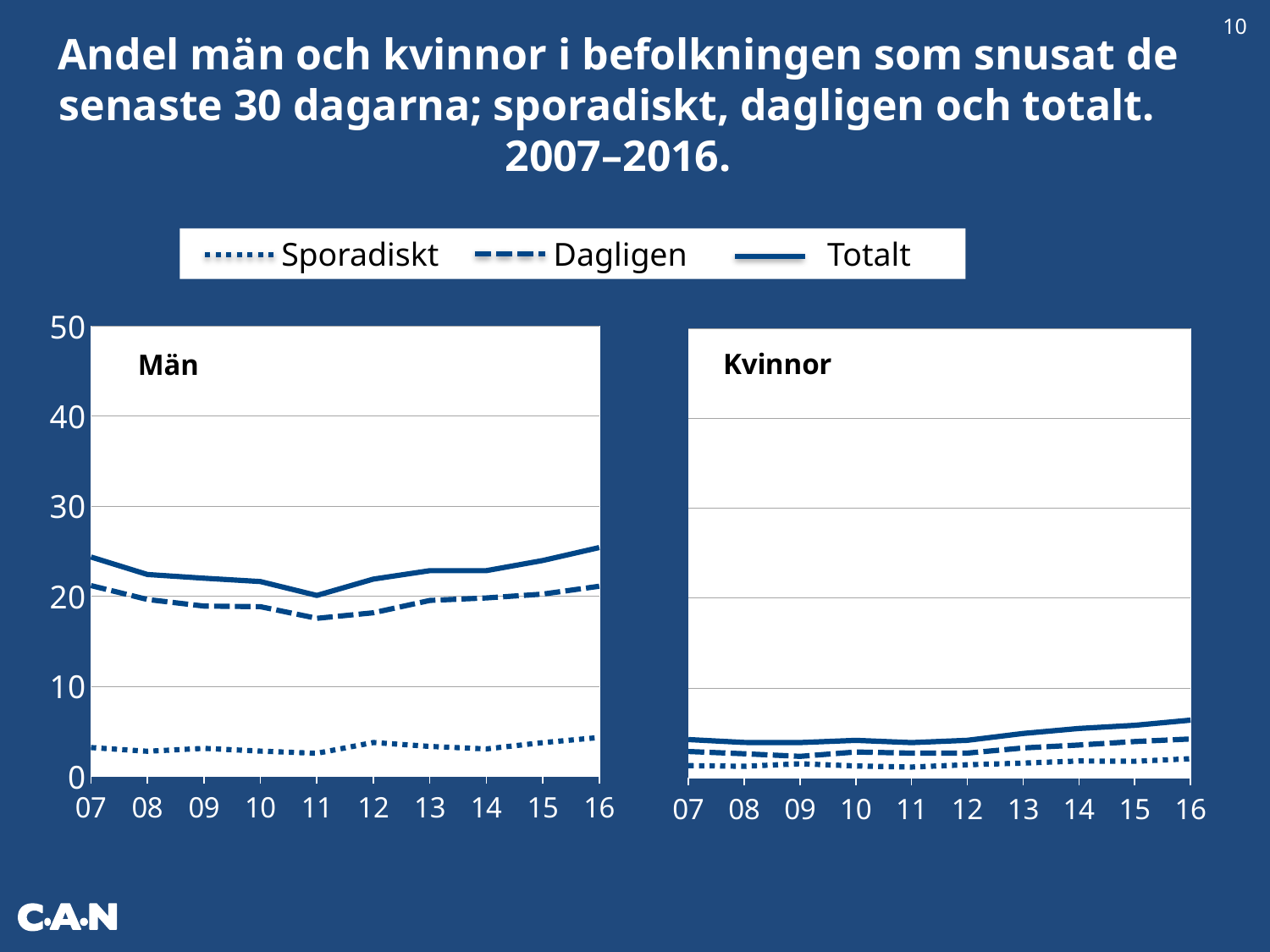
Which is larger for 16: the Totalt value in the Män chart or the Totalt value in the Kvinnor chart? Män In the Män chart, how many years are plotted along the x axis? 10 What kind of chart is used for the Män panel? line chart In the Män chart, is the Dagligen value for 11 greater or less than 20? less How many series does the legend list? 3 In the Män chart, is the Sporadiskt value for 16 greater or less than 10? less In the Kvinnor chart, is the Totalt value for 16 greater or less than 10? less Which series is drawn with a dotted line in the legend? Sporadiskt In the Män chart, which is larger for 07: Dagligen or Sporadiskt? Dagligen In the Kvinnor chart, does the Totalt series overall rise or fall from 07 to 16? rise In the Män chart, in which year is the Totalt series at its lowest? 11